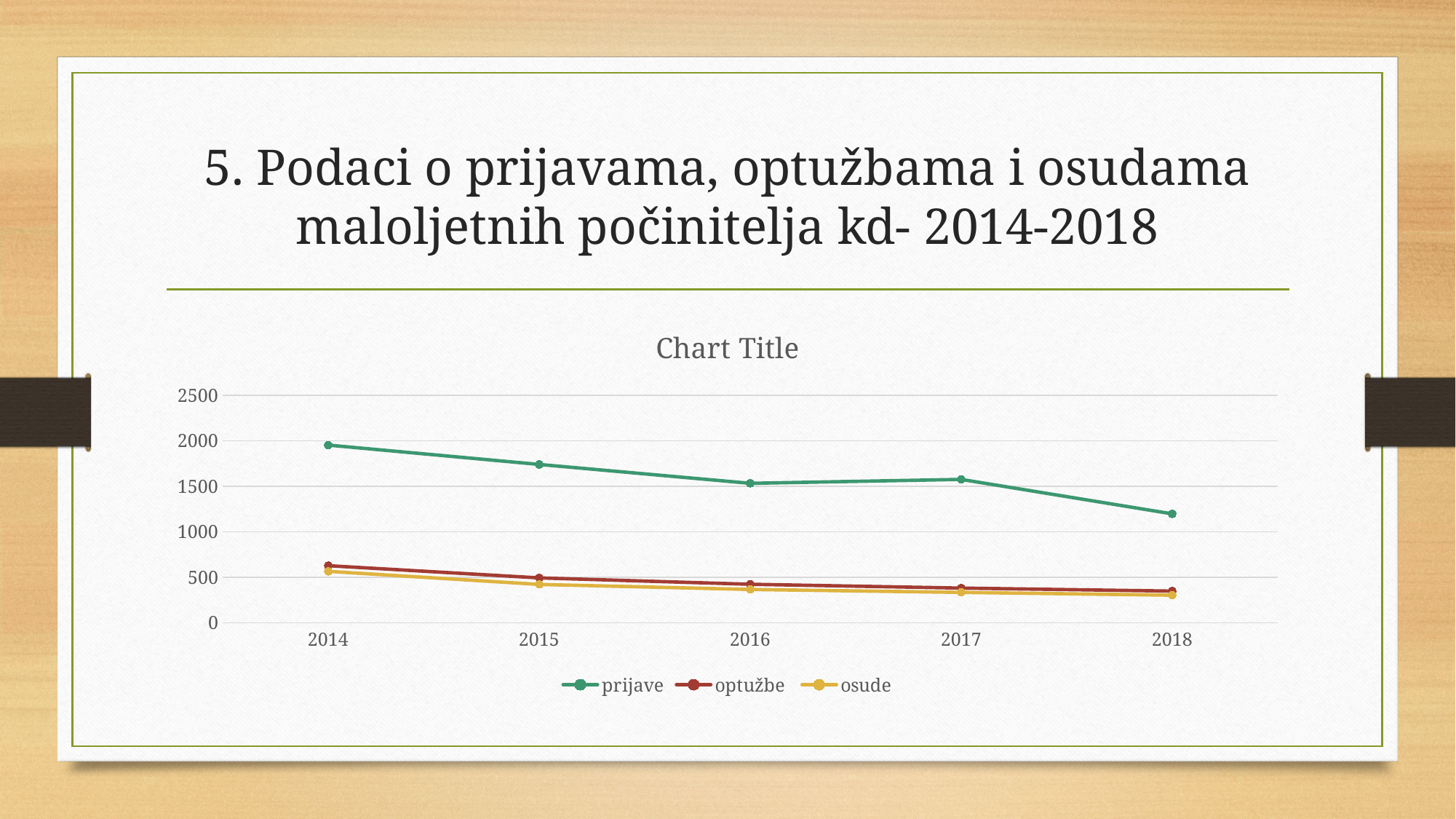
Is the value for osude in 2018 greater or less than 500? less In which year is the value for prijave lowest? 2018 Is the value for prijave in 2014 greater or less than 1500? greater Do the values for osude rise or fall from 2014 to 2018? fall In which year is the value for prijave highest? 2014 What kind of chart is shown on the slide? line chart How many series does the chart legend list? 3 Which is larger in 2014, the value for prijave or the value for optužbe? prijave How many years are shown on the x axis of the chart? 5 What is the title shown above the chart? Chart Title Is the value for prijave in 2018 greater or less than 1500? less